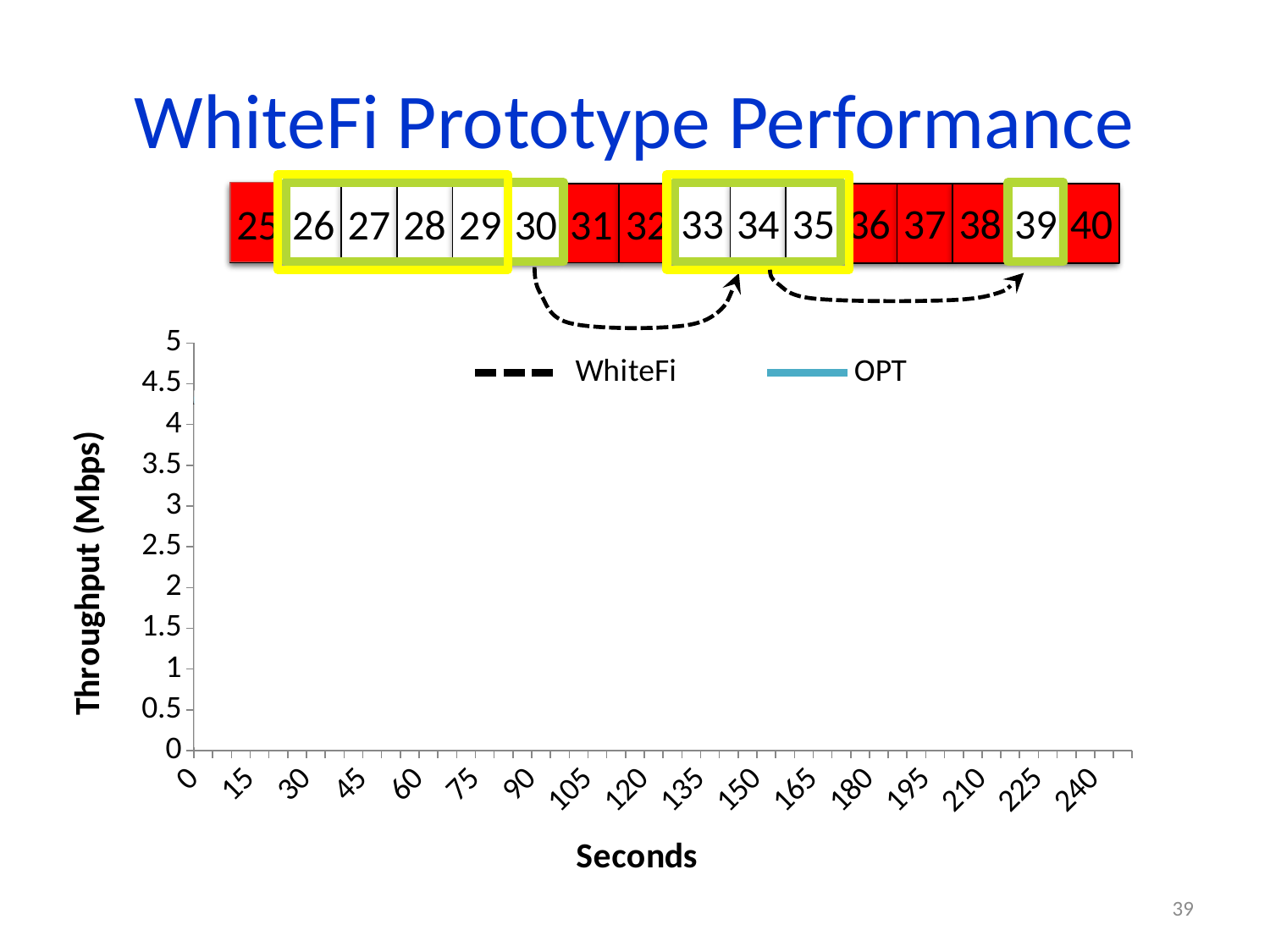
What is the interval between consecutive tick marks on the x axis? 15 What is the label of the chart's y axis? Throughput (Mbps) How many series does the chart legend list? 2 Which series in the legend is drawn with a dashed line? WhiteFi What is the label of the chart's x axis? Seconds What is the interval between consecutive tick marks on the y axis? 0.5 What is the title of the slide containing the chart? WhiteFi Prototype Performance What are the names of the two series in the chart legend? WhiteFi and OPT What is the maximum value shown on the chart's y axis? 5 What is the last tick value shown on the chart's x axis? 240